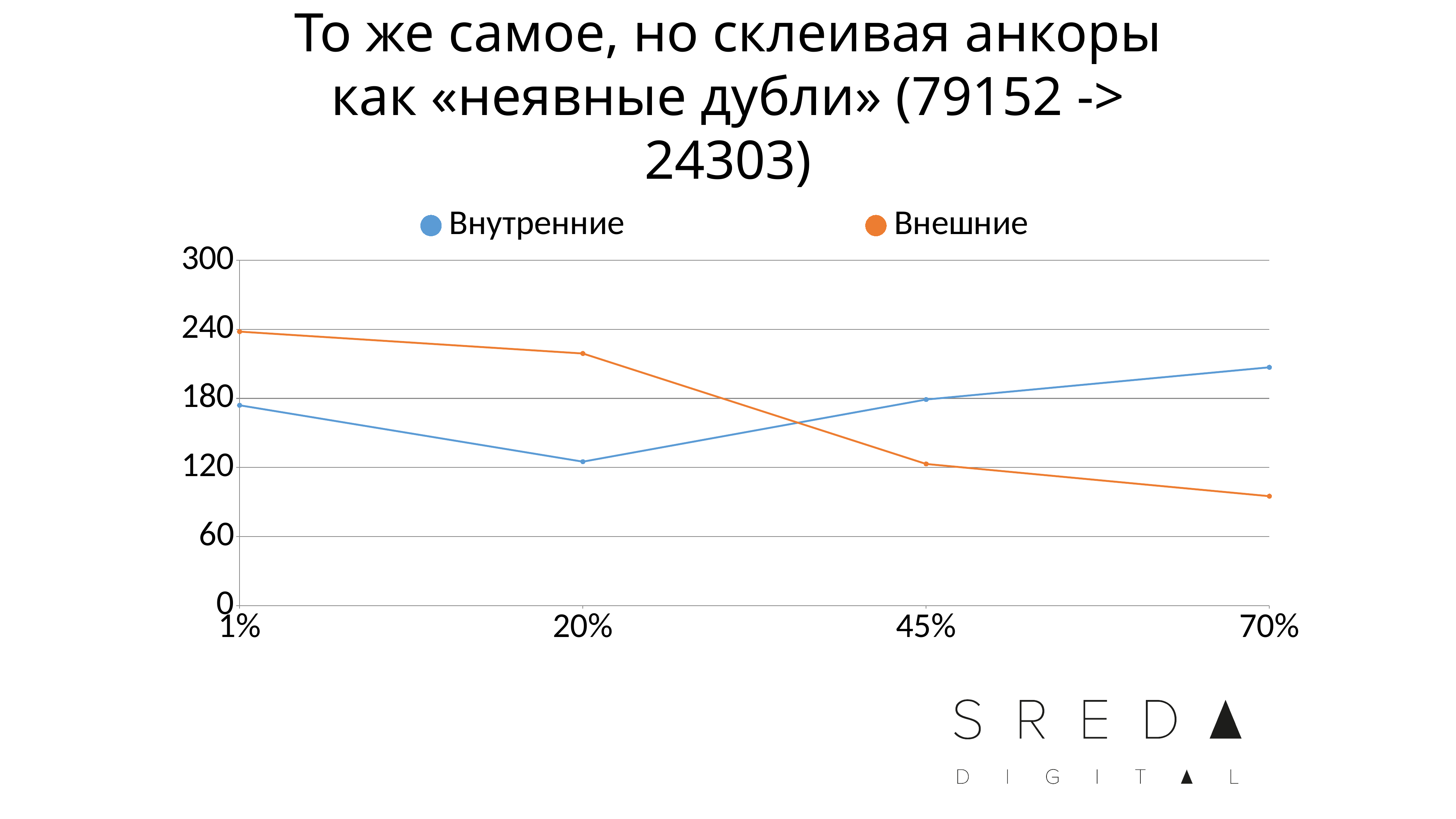
Is the value for Внешние at 1% greater or less than 180? greater At which x-axis category is the Внутренние series highest? 70% How many points are plotted along the x axis for each series? 4 At which x-axis category is the Внешние series lowest? 70% At which x-axis category is the Внутренние series lowest? 20% At 70%, which series has the larger value, Внутренние or Внешние? Внутренние At which x-axis category is the Внешние series highest? 1% Which series is shown in orange in the legend? Внешние What kind of chart is shown on the slide? line chart How many series does the legend list? 2 Is the value for Внутренние at 20% greater or less than 180? less Does the Внешние series rise or fall as you move from 1% to 70% along the x axis? fall